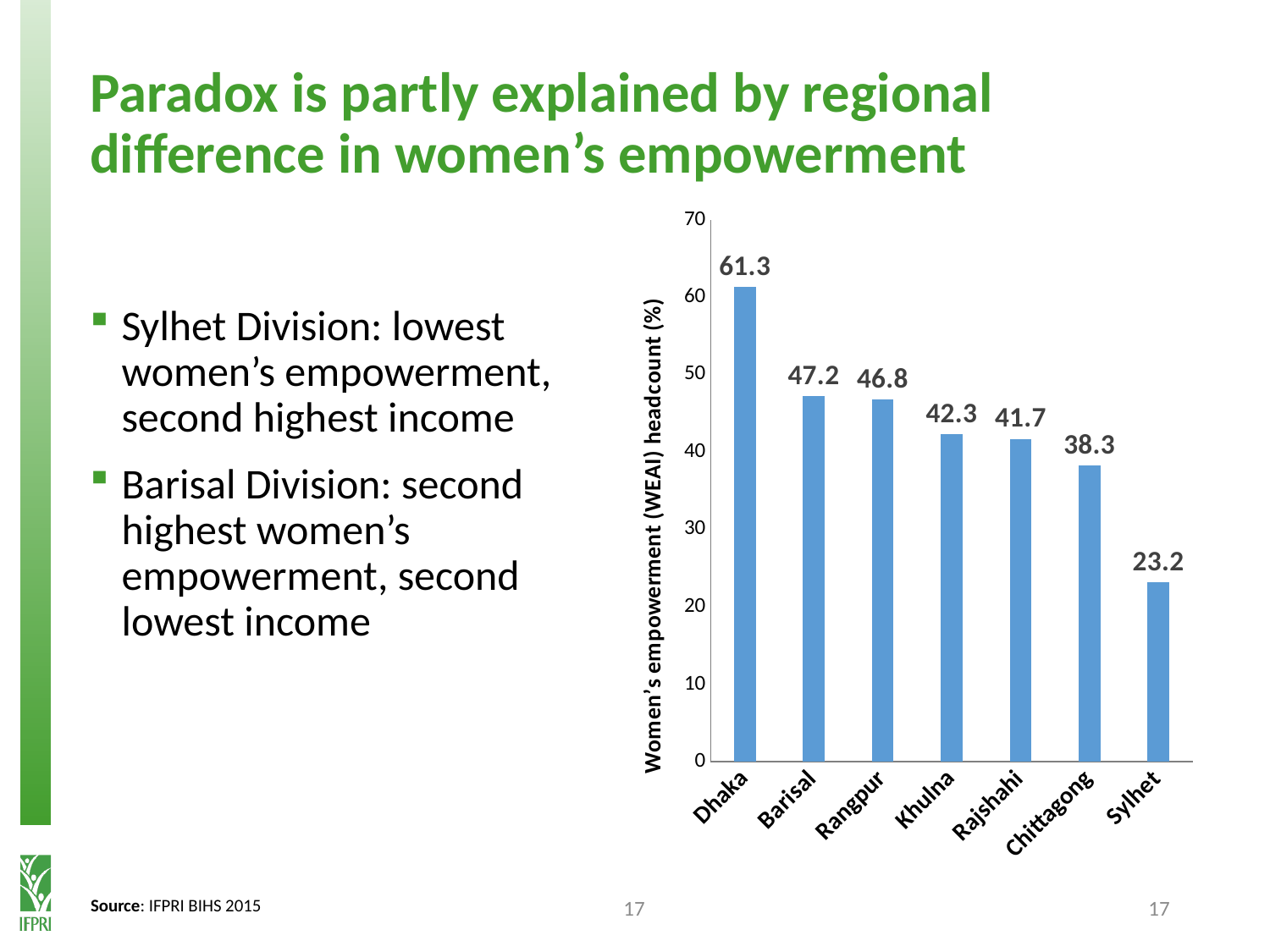
What is the women's empowerment (WEAI) headcount value for Dhaka? 61.3 Do the values rise or fall moving from Dhaka to Sylhet along the x axis? Fall What is the value shown for Khulna? 42.3 Which has a higher value, Rangpur or Rajshahi? Rangpur What is the difference between the values for Dhaka and Sylhet? 38.1 Which division has the lowest women's empowerment (WEAI) headcount? Sylhet Which division has the highest women's empowerment (WEAI) headcount? Dhaka How many divisions are shown on the chart? 7 What is the value shown for Sylhet? 23.2 What kind of chart is shown on the slide? Bar chart Is the value for Chittagong greater or less than 40? less What is the difference between the values for Barisal and Chittagong? 8.9